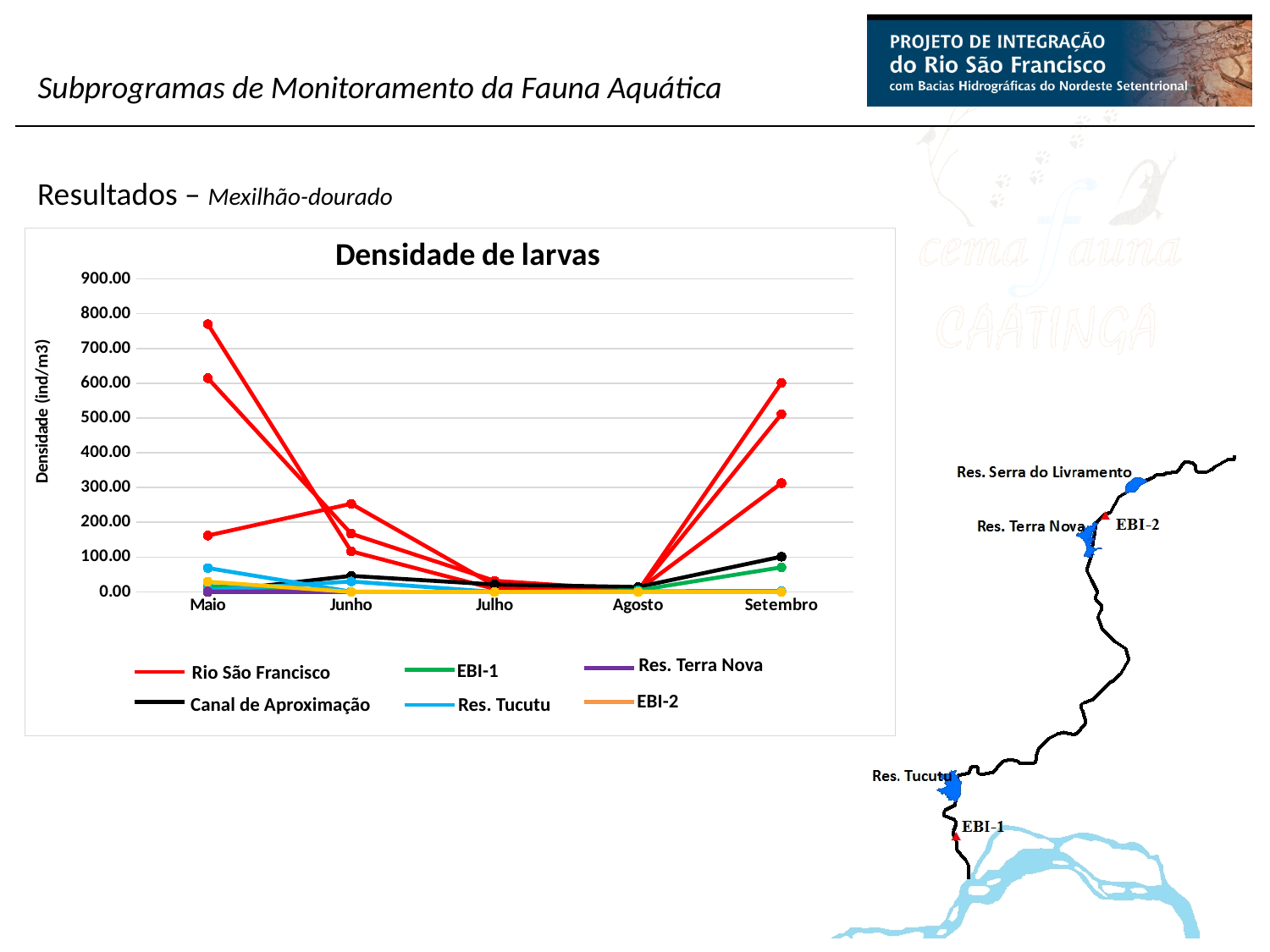
What kind of chart is shown on the slide? line chart What is the title of the chart? Densidade de larvas How many months are shown along the x axis of the chart? 5 Is the value for Canal de Aproximação in Setembro greater or less than 200? less How many series does the chart legend list? 6 What is the label of the vertical axis of the chart? Densidade (ind/m3) Is the value for Res. Tucutu in Maio greater or less than 100? less Is the highest value plotted for Maio greater or less than 700? greater In which month does the chart reach its highest plotted value? Maio Does the value for Canal de Aproximação rise or fall from Agosto to Setembro? rise Which is larger: the highest value plotted in Maio or the highest value plotted in Setembro? Maio